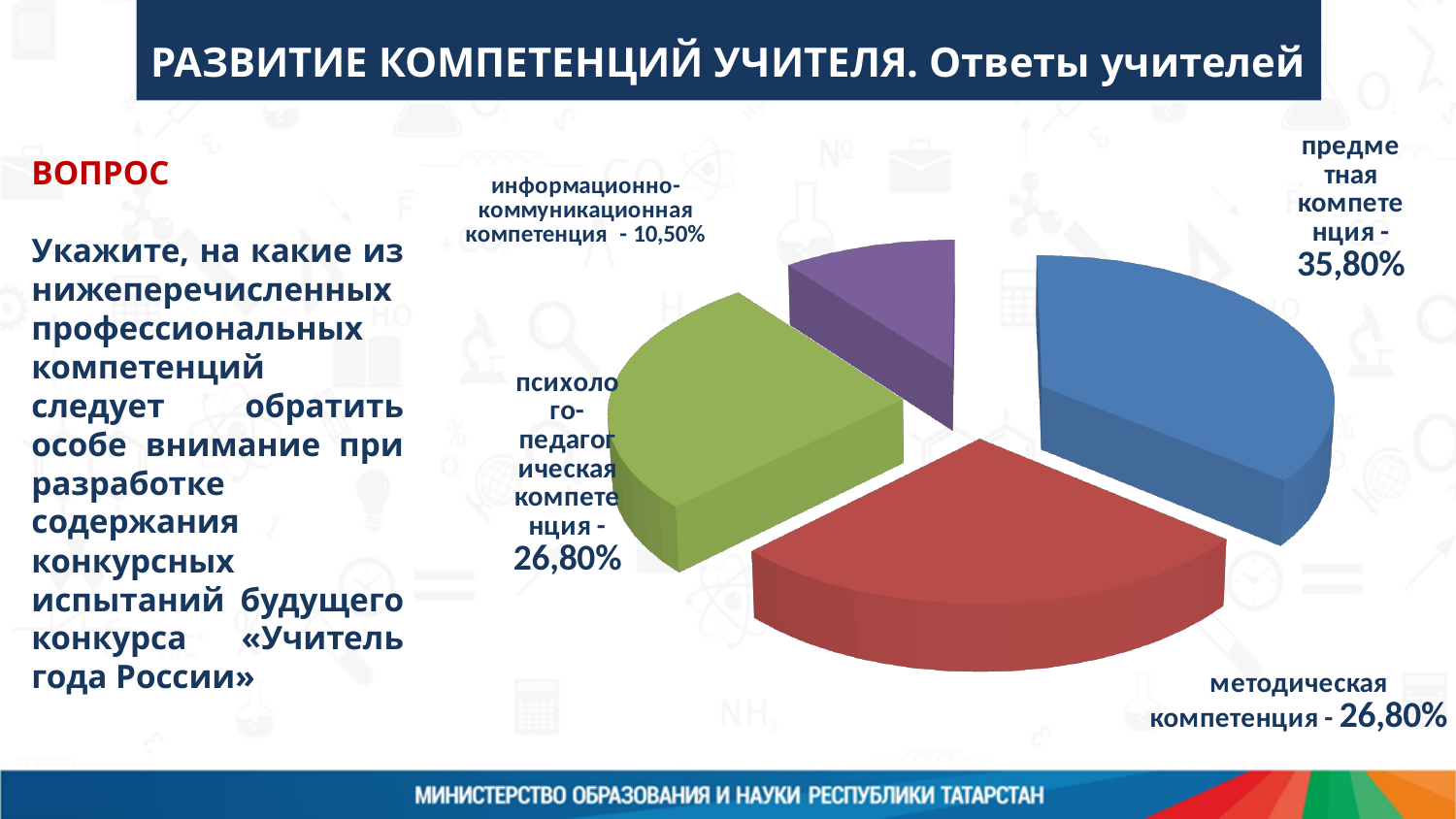
What is the value for информационно-коммуникационная компетенция? 10,50% What is the difference between the shares of предметная компетенция and методическая компетенция? 9,00% What colour is the slice for методическая компетенция? Red Which competency has the smallest share of the pie? информационно-коммуникационная компетенция Which is larger: the share of предметная компетенция or the share of методическая компетенция? предметная компетенция What is the difference between the shares of предметная компетенция and информационно-коммуникационная компетенция? 25,30% What is the value for методическая компетенция? 26,80% Which competency has the largest share of the pie? предметная компетенция What is the value for психолого-педагогическая компетенция? 26,80% How many slices does the pie chart have? 4 What kind of chart is shown on the slide? Pie chart What share of the pie does предметная компетенция have? 35,80%